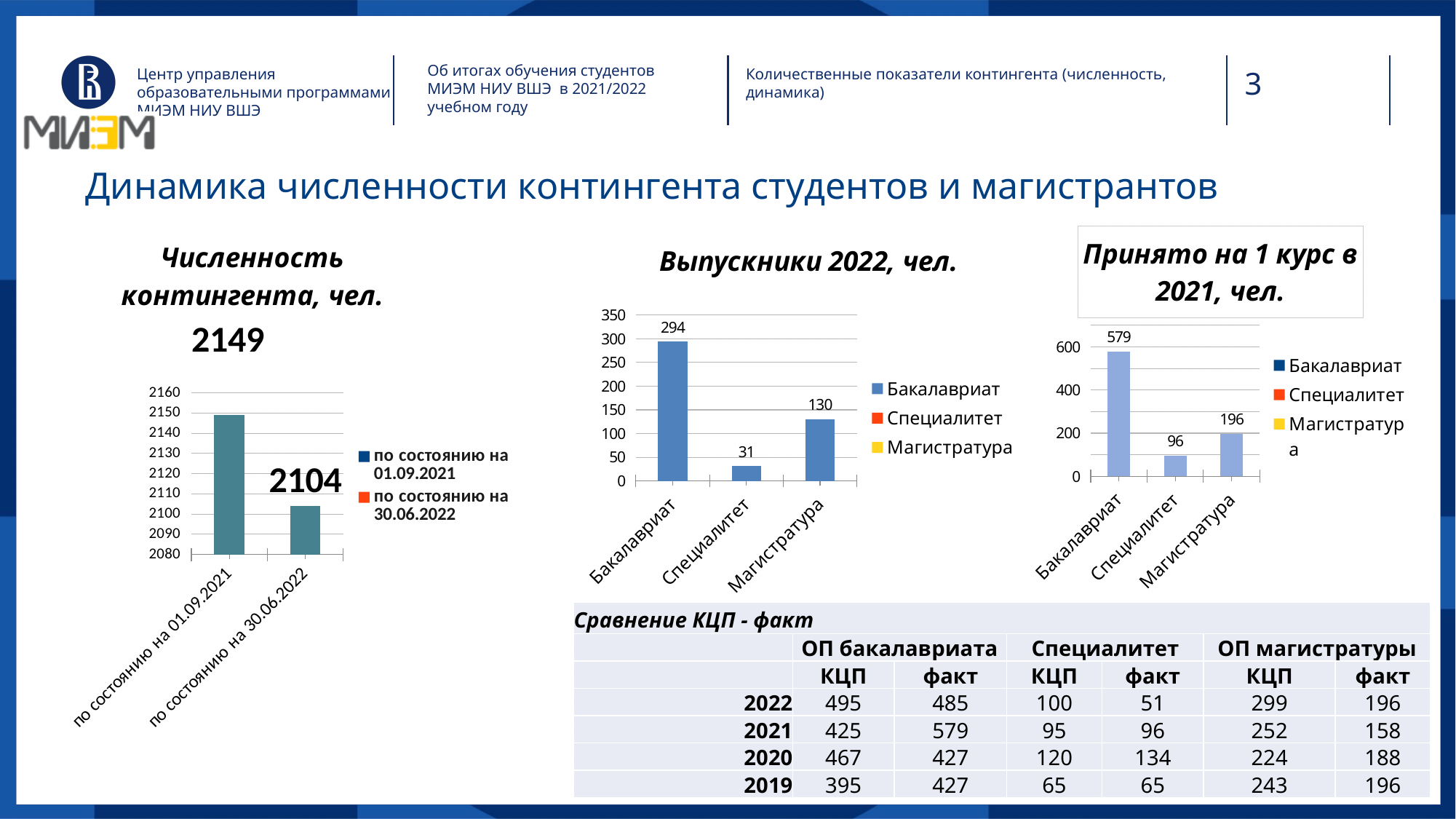
In the chart 'Принято на 1 курс в 2021, чел.', which is larger: Магистратура or Специалитет? Магистратура In the chart 'Выпускники 2022, чел.', what is the value for Бакалавриат? 294 In the chart 'Численность контингента, чел.', what is the value for 'по состоянию на 30.06.2022'? 2104 In the chart 'Выпускники 2022, чел.', what is the difference between Бакалавриат and Магистратура? 164 In the chart 'Численность контингента, чел.', do the values rise or fall from the first date to the second? fall In the chart 'Принято на 1 курс в 2021, чел.', what is the value for Специалитет? 96 In the chart 'Выпускники 2022, чел.', which category has the lowest value? Специалитет In the chart 'Численность контингента, чел.', what is the value for 'по состоянию на 01.09.2021'? 2149 In the chart 'Выпускники 2022, чел.', how many categories are shown on the x axis? 3 In the chart 'Принято на 1 курс в 2021, чел.', which category has the highest value? Бакалавриат In the chart 'Численность контингента, чел.', what is the difference between the value on 01.09.2021 and the value on 30.06.2022? 45 What type of chart is 'Принято на 1 курс в 2021, чел.'? bar chart